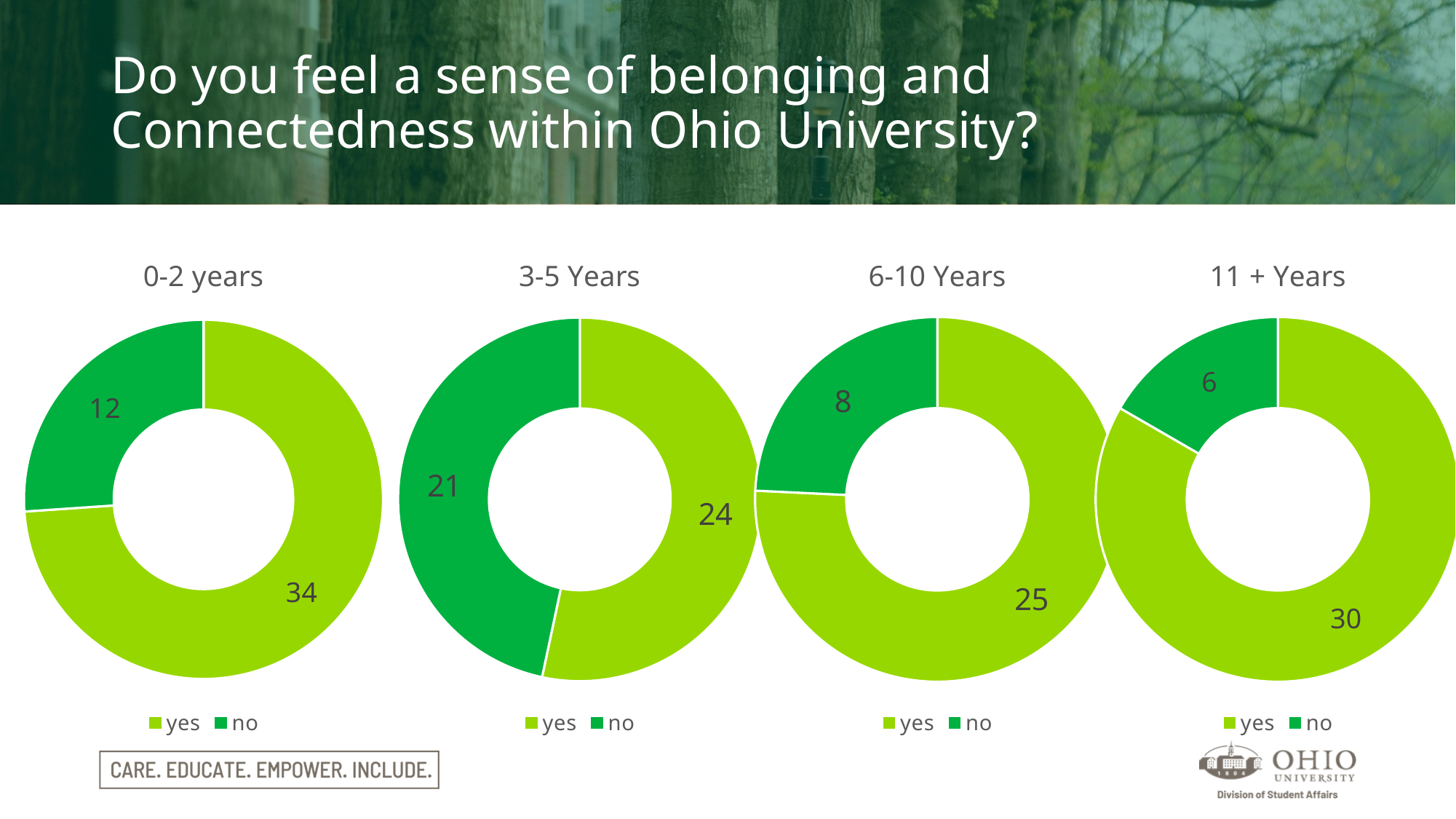
In the '0-2 years' chart, what share of the total does 'no' represent? 26% How many entries does the legend of the '11 + Years' chart list? 2 In the '6-10 Years' chart, what is the value for 'yes'? 25 In the '6-10 Years' chart, what is the total of 'yes' and 'no'? 33 How many slices does the '6-10 Years' chart have? 2 In the '11 + Years' chart, which is larger, 'yes' or 'no'? yes In the '3-5 Years' chart, what is the difference between 'yes' and 'no'? 3 In the '11 + Years' chart, what is the value for 'no'? 6 In the '0-2 years' chart, what is the value for 'yes'? 34 What kind of chart is the '3-5 Years' chart? Doughnut chart In the '3-5 Years' chart, what is the value for 'no'? 21 In the '0-2 years' chart, what is the value for 'no'? 12